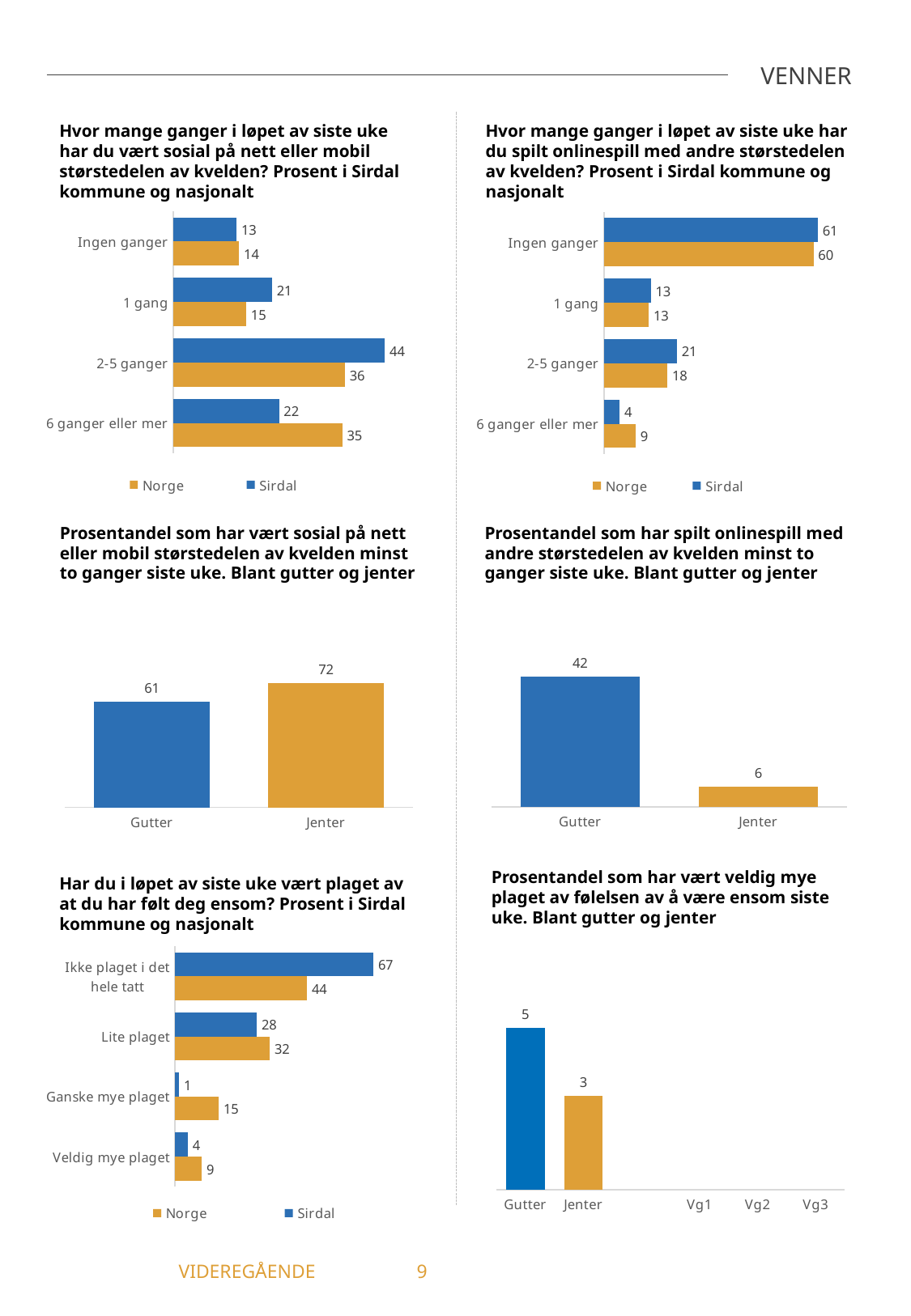
In the middle-right chart about playing online games at least twice last week, what is the difference between Gutter and Jenter? 36 In the top-left chart about being social online or on mobile most of the evening, what is the value for Sirdal in the '2-5 ganger' category? 44 In the top-right chart about playing online games with others, which category has the highest value for Sirdal? Ingen ganger In the bottom-left chart about feeling lonely last week, what is the value for Sirdal in the 'Ikke plaget i det hele tatt' category? 67 In the bottom-left chart about feeling lonely last week, which category has the lowest value for Sirdal? Ganske mye plaget In the top-left chart about being social online or on mobile, what is the difference between Norge and Sirdal for '6 ganger eller mer'? 13 In the middle-left chart about being social online at least twice last week among boys and girls, which group has the higher value, Gutter or Jenter? Jenter In the top-right chart about playing online games with others, what is the value for Norge in the '6 ganger eller mer' category? 9 In the bottom-right chart about being very bothered by loneliness among boys and girls, what is the value for Jenter? 3 In the bottom-left chart about feeling lonely last week, how many categories are shown? 4 In the middle-right chart about playing online games at least twice last week among boys and girls, what is the value for Gutter? 42 In the top-right chart about playing online games with others, how many series does the legend list? 2